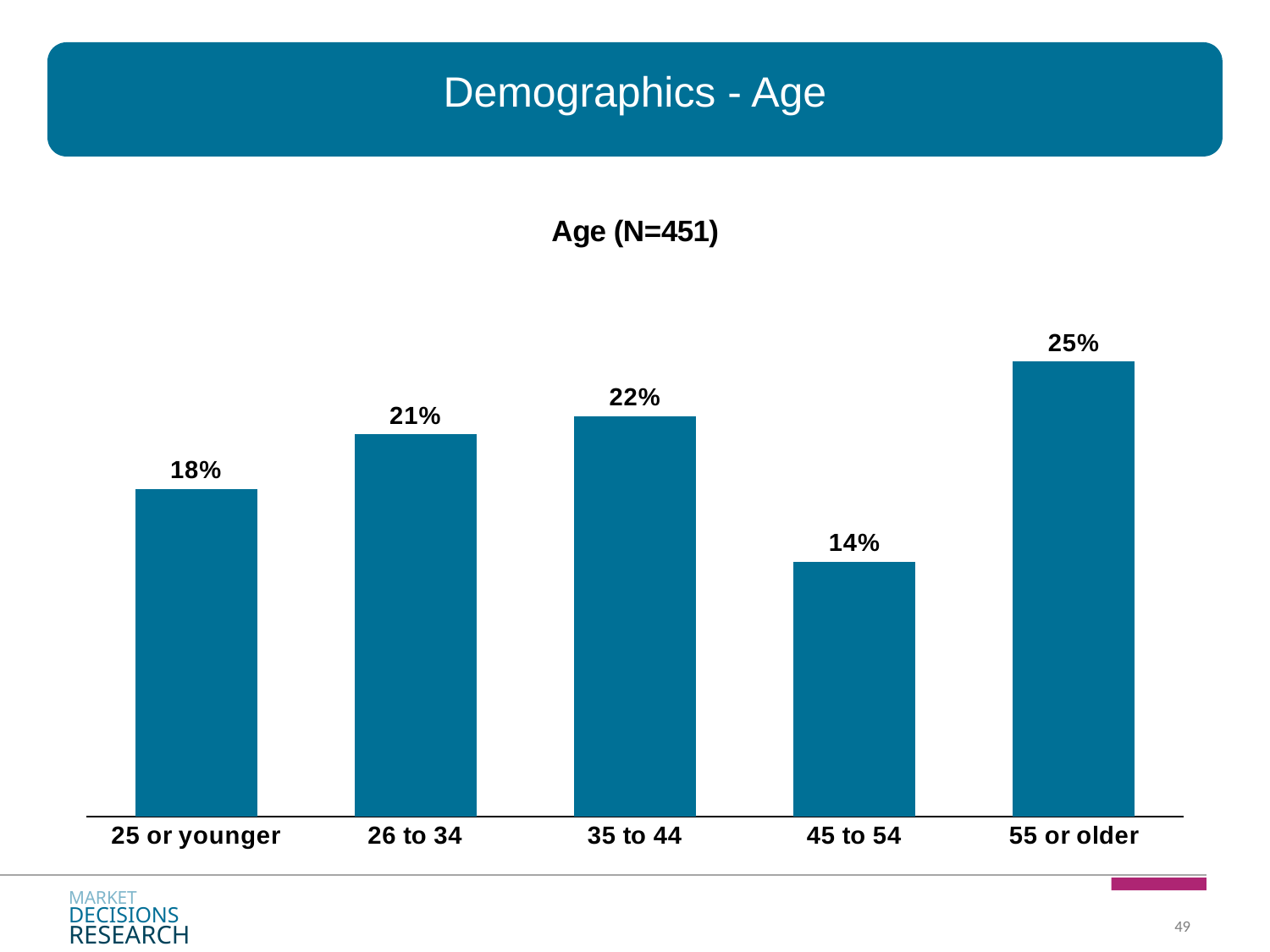
Which age group has the highest percentage? 55 or older Which is larger, the value for 26 to 34 or the value for 25 or younger? 26 to 34 What is the title of the chart? Age (N=451) How many age groups are shown in the chart? 5 What is the value shown for the 45 to 54 age group? 14% What is the difference in percentage points between the 55 or older group and the 45 to 54 group? 11 percentage points What is the sample size (N) given in the chart title? 451 What percentage of respondents are 25 or younger? 18% What percentage of respondents are 55 or older? 25% What kind of chart is shown on the slide? Bar chart Which age group has the lowest percentage? 45 to 54 What is the difference between the 35 to 44 group and the 26 to 34 group? 1 percentage point